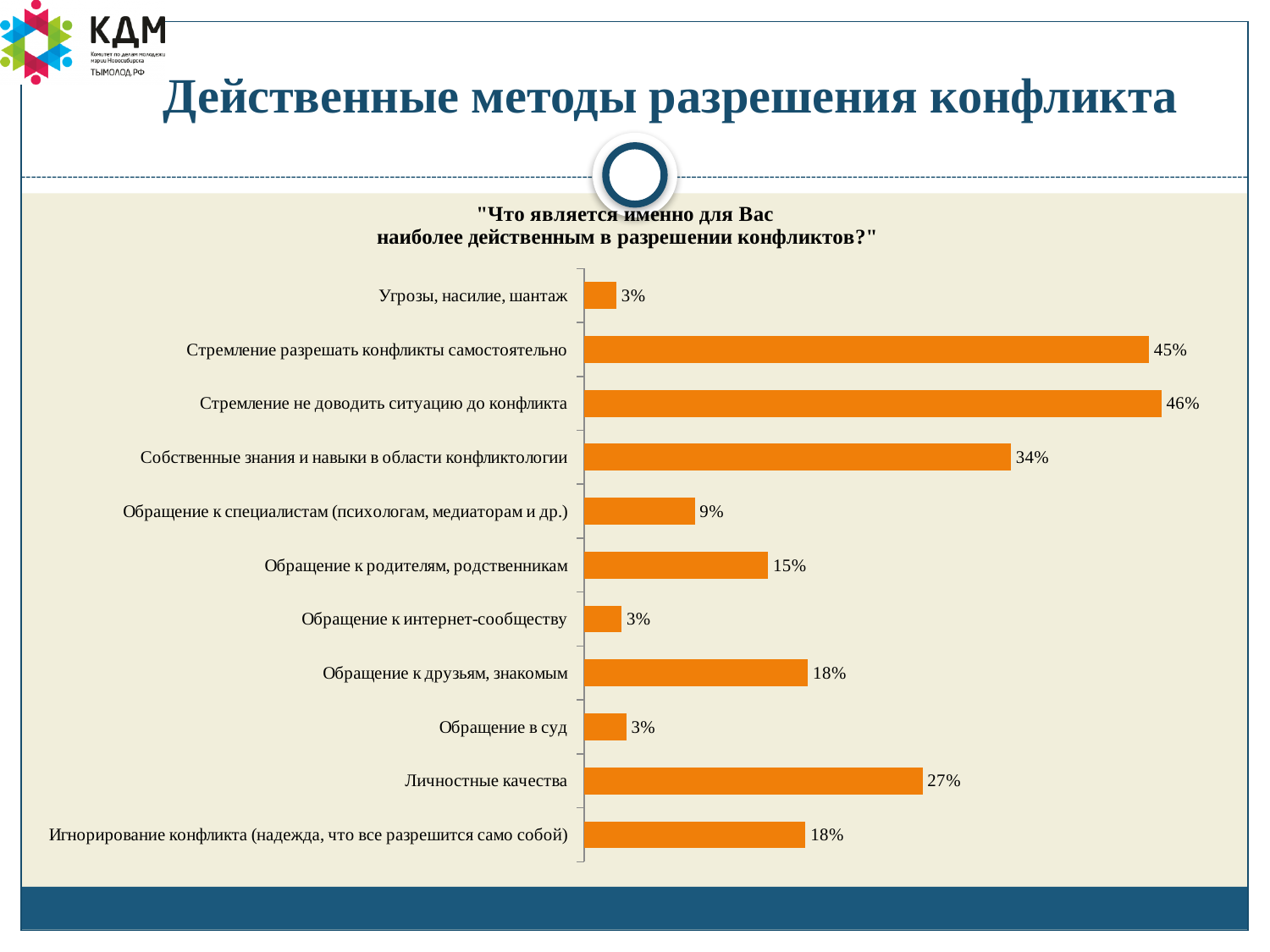
What is the value for "Обращение к специалистам (психологам, медиаторам и др.)"? 9% What is the value for "Личностные качества"? 27% Which is larger: "Обращение к родителям, родственникам" or "Обращение к друзьям, знакомым"? Обращение к друзьям, знакомым How many categories are shown in the chart? 11 What is the difference between "Личностные качества" and "Обращение к друзьям, знакомым"? 9% What is the value for "Стремление разрешать конфликты самостоятельно"? 45% What is the value for "Обращение к родителям, родственникам"? 15% What question is shown as the chart's title? "Что является именно для Вас наиболее действенным в разрешении конфликтов?" What is the difference between "Стремление не доводить ситуацию до конфликта" and "Собственные знания и навыки в области конфликтологии"? 12% Which category has the highest value? Стремление не доводить ситуацию до конфликта What type of chart is shown on the slide? bar chart What is the value for "Собственные знания и навыки в области конфликтологии"? 34%